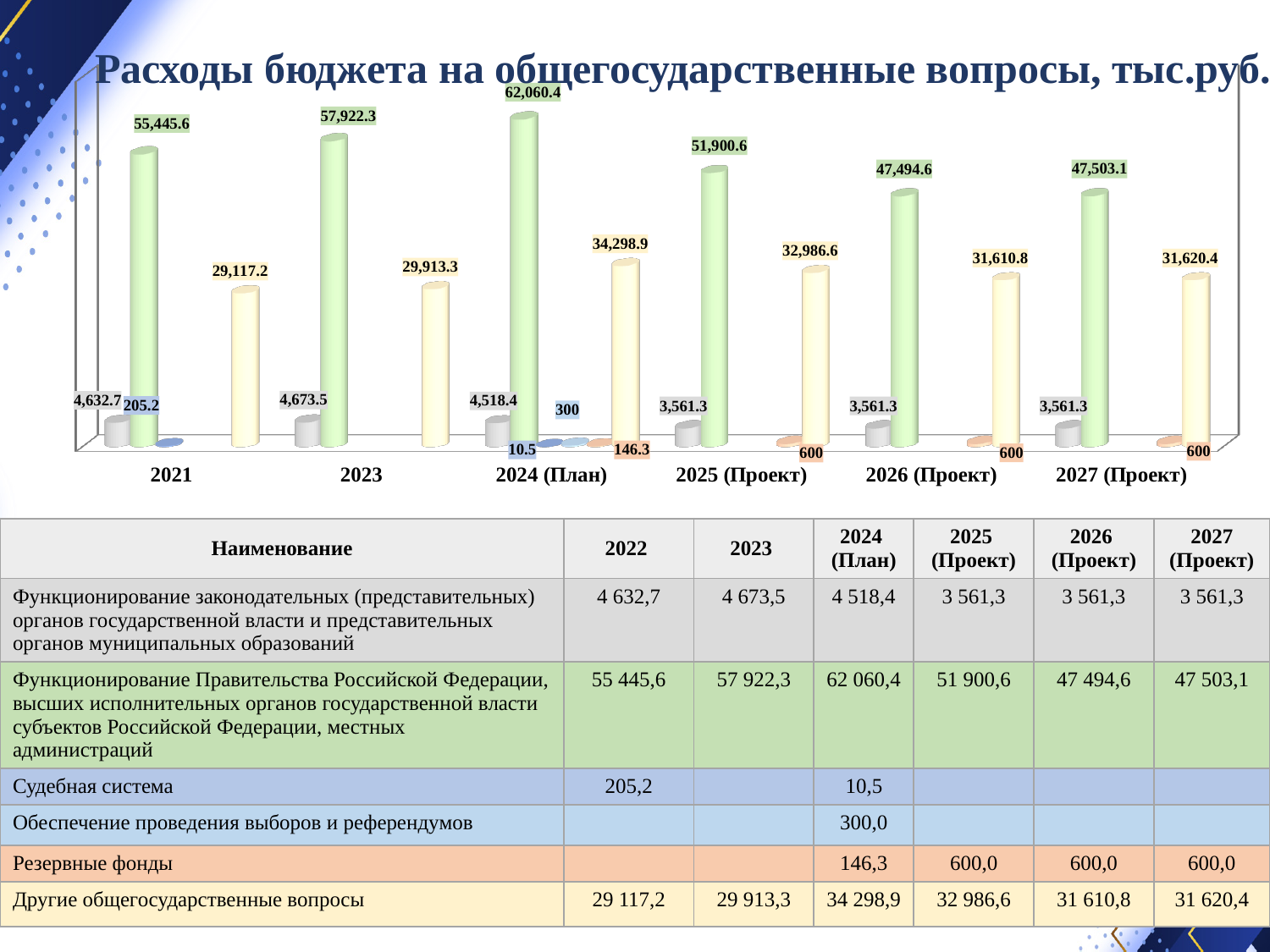
What kind of chart is shown on the slide? Bar chart What is the difference between the green bar for 2024 (План) and the green bar for 2023? 4,138.1 Which category has the tallest green bar? 2024 (План) Which is larger, the green bar for 2025 (Проект) or the green bar for 2026 (Проект)? 2025 (Проект) What is the difference between the yellow bar for 2024 (План) and the yellow bar for 2023? 4,985.6 What is the value of the grey bar for 2021? 4,632.7 What is the smallest labelled value on the chart? 10.5 Do the green bars rise or fall from 2024 (План) to 2026 (Проект)? Fall What is the value of the yellow bar for 2025 (Проект)? 32,986.6 What is the value of the green bar for 2024 (План)? 62,060.4 What is the value of the orange bar for 2027 (Проект)? 600 How many categories are shown on the x axis of the chart? 6